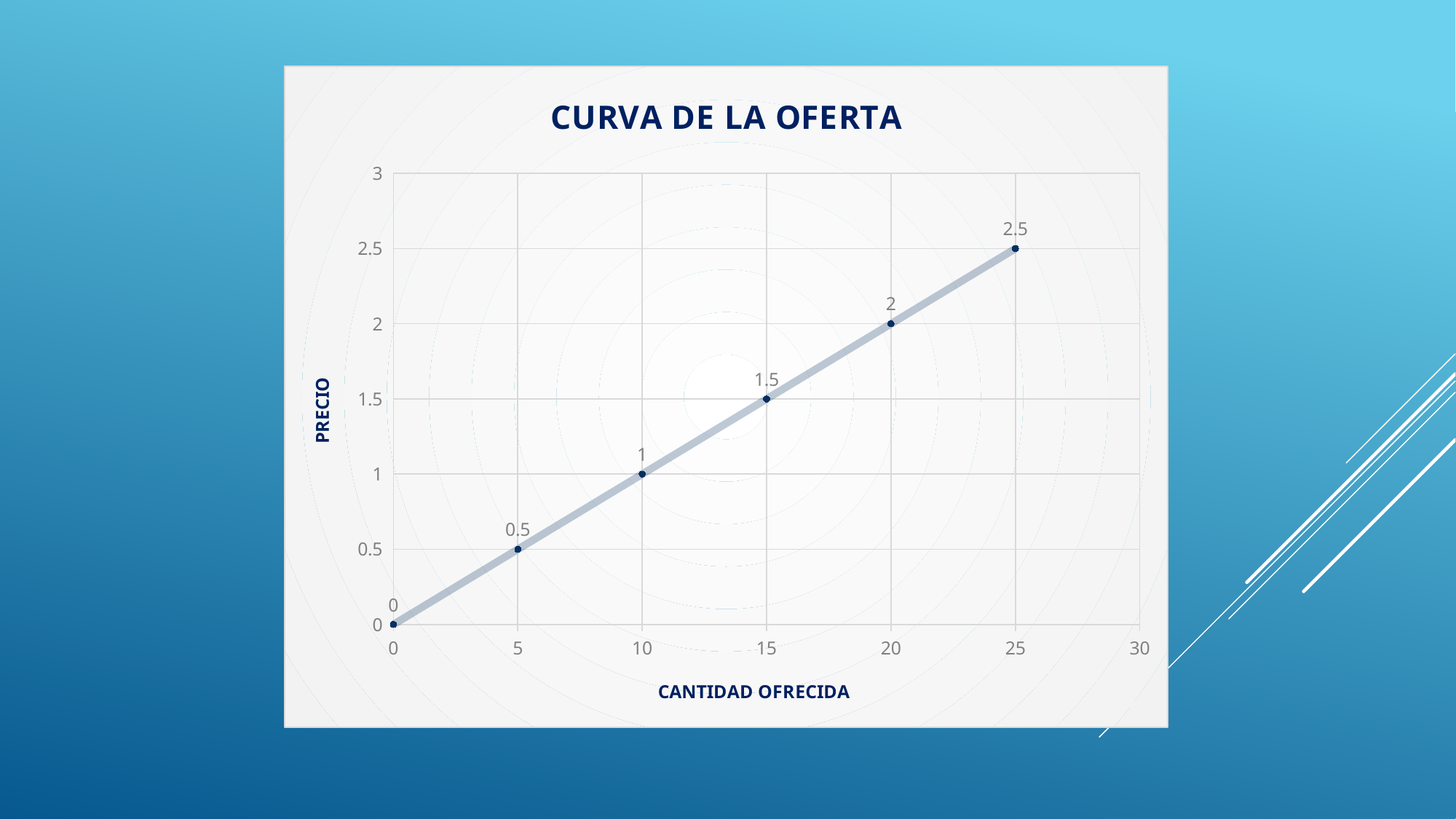
How many data points are plotted on the line? 6 What is the PRECIO value when CANTIDAD OFRECIDA is 5? 0.5 Which has a higher PRECIO: CANTIDAD OFRECIDA 15 or CANTIDAD OFRECIDA 20? CANTIDAD OFRECIDA 20 What is the PRECIO value when CANTIDAD OFRECIDA is 20? 2 Does PRECIO rise or fall as CANTIDAD OFRECIDA increases? rise At which CANTIDAD OFRECIDA value is PRECIO lowest? 0 What is the title of the chart? CURVA DE LA OFERTA What is the PRECIO value when CANTIDAD OFRECIDA is 25? 2.5 What type of chart is shown on the slide? line chart What is the difference in PRECIO between CANTIDAD OFRECIDA 25 and CANTIDAD OFRECIDA 10? 1.5 At which CANTIDAD OFRECIDA value is PRECIO highest? 25 What is the PRECIO value when CANTIDAD OFRECIDA is 10? 1